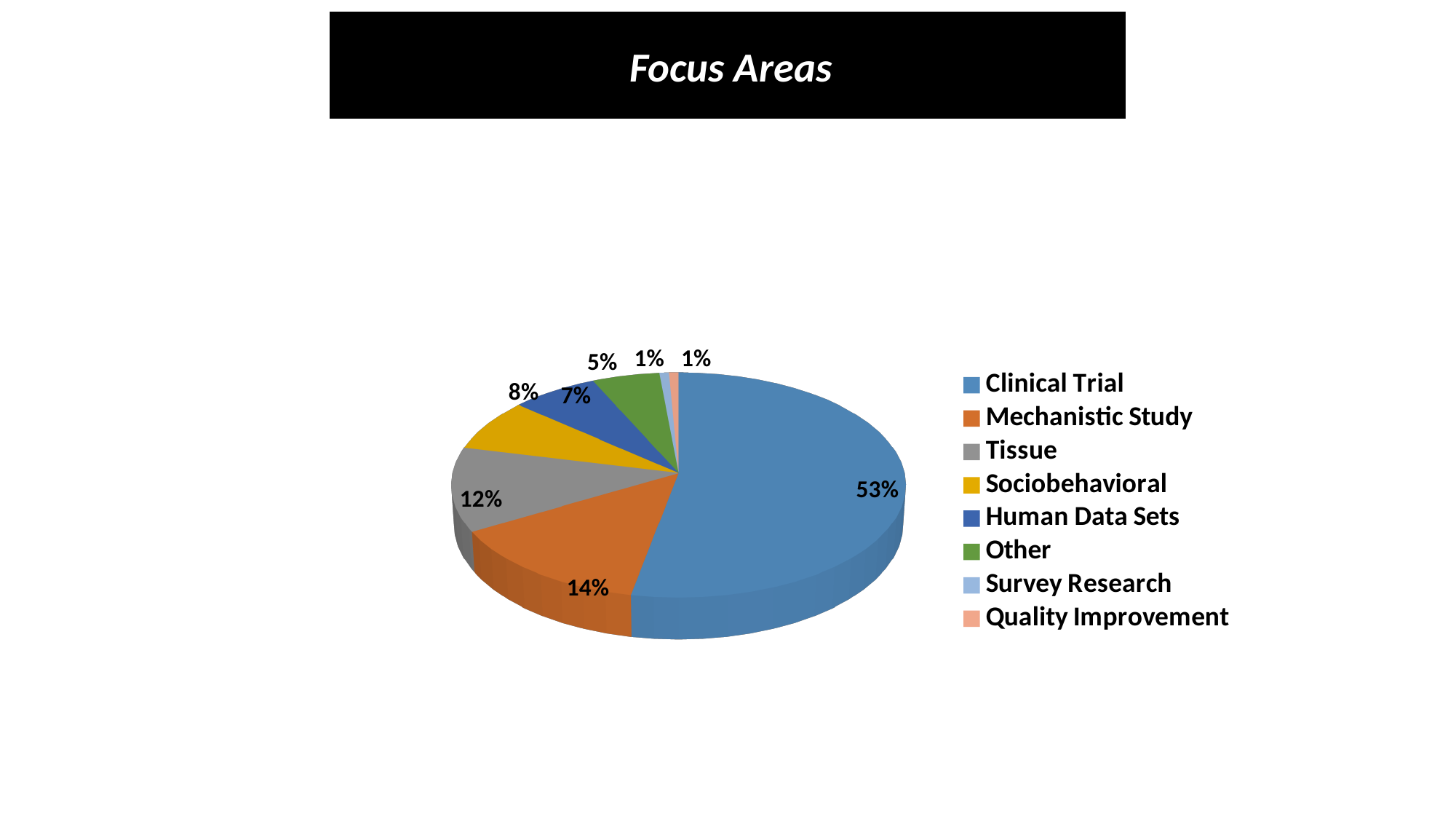
Which is larger, the share for Tissue or the share for Sociobehavioral? Tissue What type of chart is shown on the slide? Pie chart What colour is the Other slice in the pie chart? Green How many categories does the legend list? 8 What is the title of the chart? Focus Areas Which focus area has the largest share of the pie? Clinical Trial What percentage is shown for Tissue? 12% What is the difference in percentage points between Clinical Trial and Mechanistic Study? 39 What share of the pie does Clinical Trial represent? 53% What percentage is shown for Human Data Sets? 7% What percentage is shown for Mechanistic Study? 14% What percentage is shown for Sociobehavioral? 8%